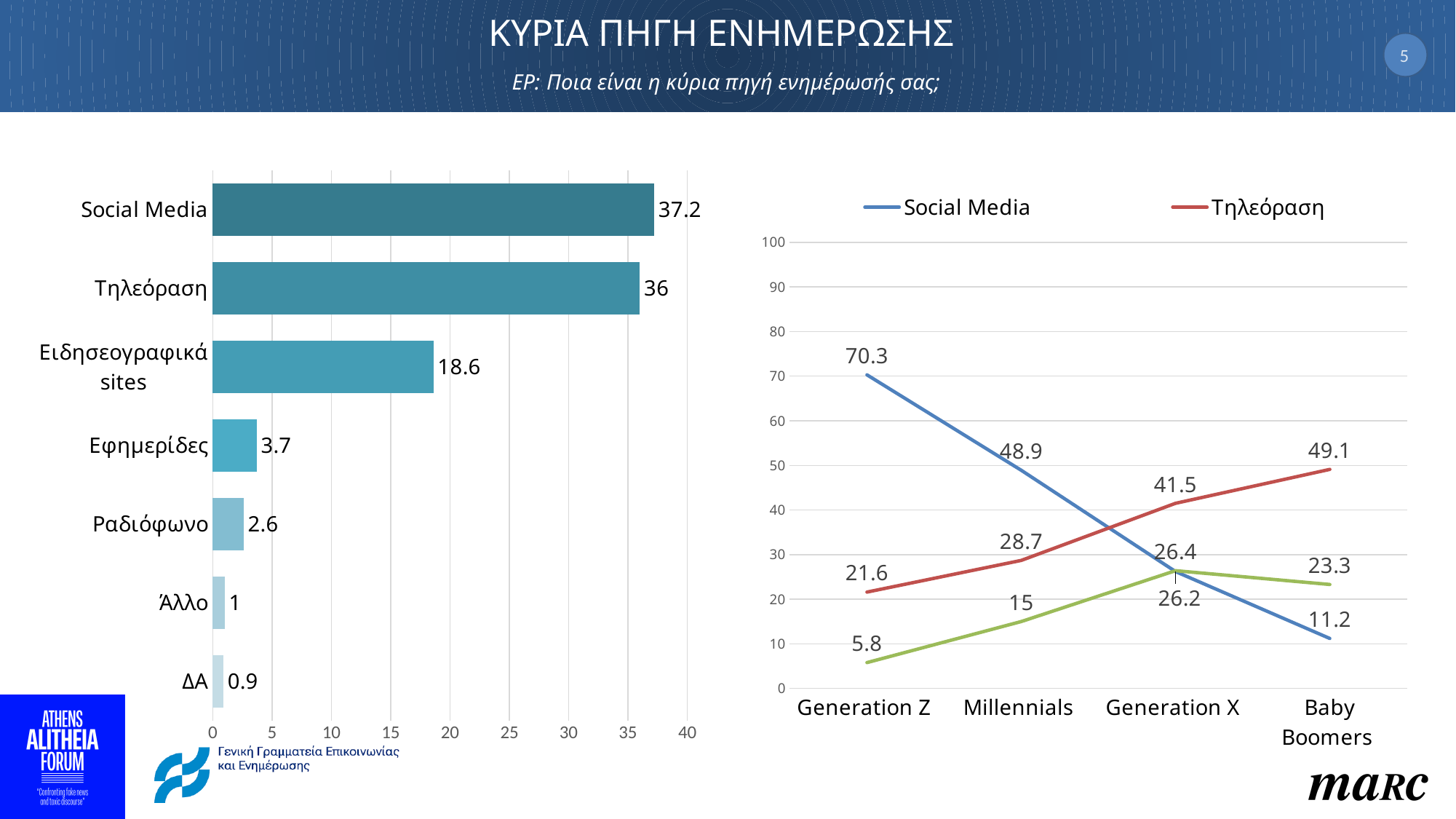
In the bar chart on the left, what is the difference between Social Media and Τηλεόραση? 1.2 In the line chart on the right, what is the Τηλεόραση value for Baby Boomers? 49.1 In the bar chart on the left, which category has the lowest value? ΔΑ In the line chart on the right, how many series does the legend list? 2 In the bar chart on the left, which category has the highest value? Social Media In the line chart on the right, does the Social Media line rise or fall from Generation Z to Baby Boomers? fall In the line chart on the right, what is the Social Media value for Generation Z? 70.3 In the bar chart on the left, how many categories are shown? 7 What kind of chart is on the left side of the slide? bar chart In the bar chart on the left, what is the value for Ειδησεογραφικά sites? 18.6 In the line chart on the right, which is larger for Millennials: Social Media or Τηλεόραση? Social Media In the bar chart on the left, what is the value for Social Media? 37.2